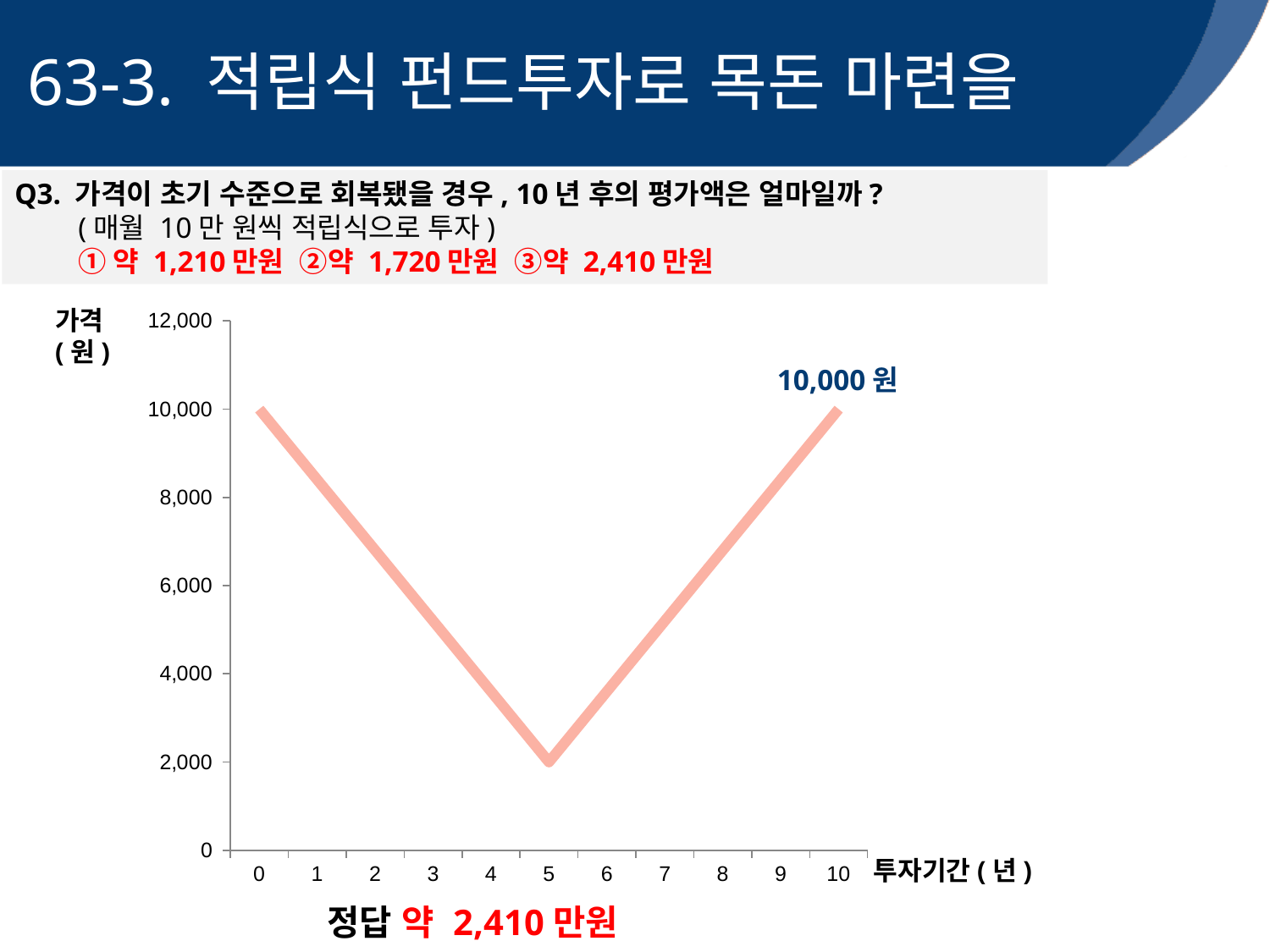
Which is larger, the price at year 5 or the price at year 10? year 10 What is the price (원) at investment year 10 according to the data label? 10,000 원 What is the label of the x axis? 투자기간 ( 년 ) What is the difference between the price at year 0 and the price at year 5? 8,000 What kind of chart is shown on the slide? line chart What is the price at investment year 0? 10,000 Does the price rise or fall from year 0 to year 5? fall Is the price at investment year 3 greater or less than 6,000? less At which investment year is the price lowest? 5 What is the price at investment year 5? 2,000 How many investment-year points are marked on the x axis? 11 Is the price at investment year 8 greater or less than 6,000? greater